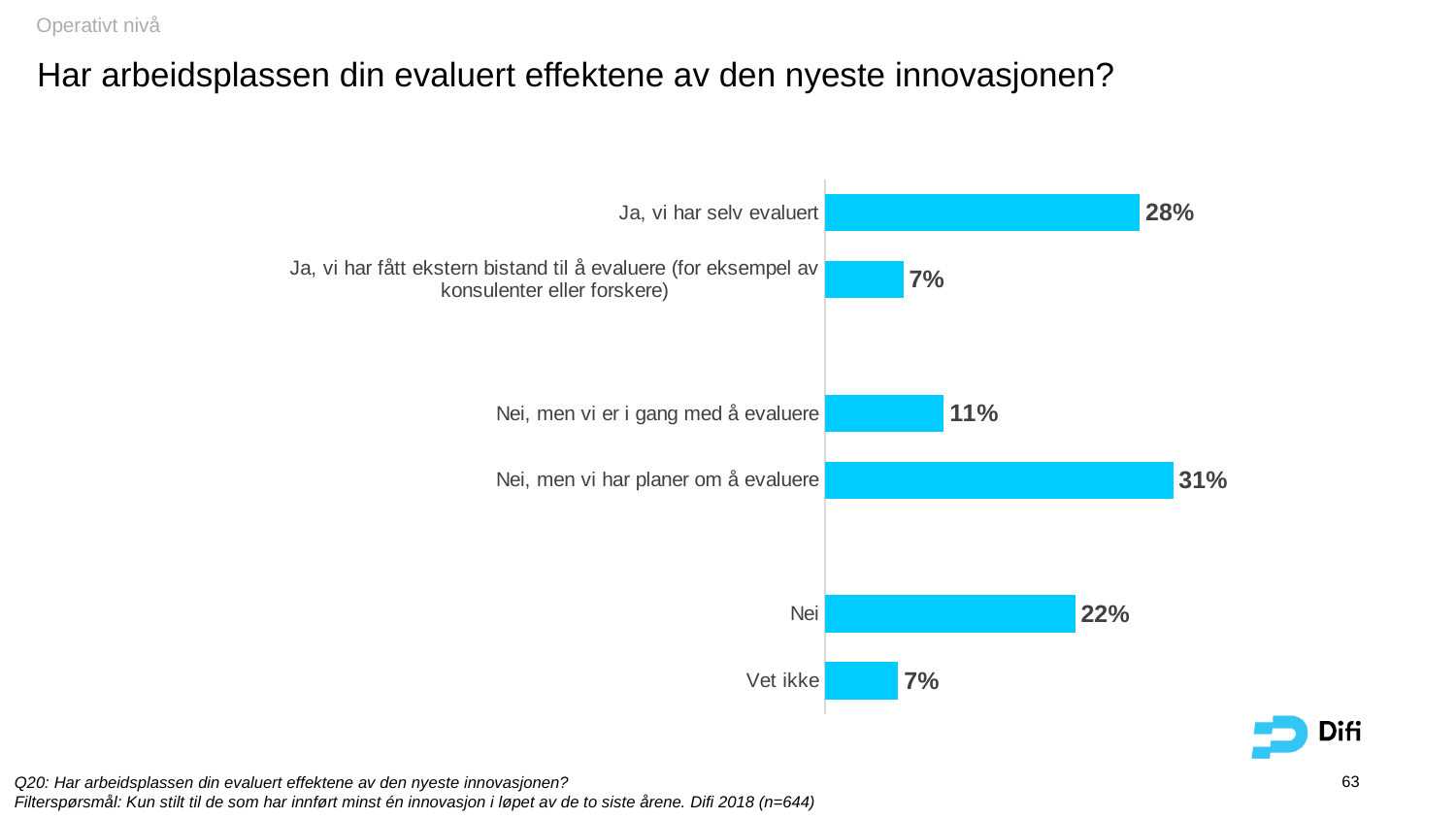
What percentage is shown for "Nei, men vi har planer om å evaluere"? 31% What is the difference between "Nei" and "Nei, men vi er i gang med å evaluere"? 11% What is the title of the slide? Har arbeidsplassen din evaluert effektene av den nyeste innovasjonen? What is the difference between "Nei, men vi har planer om å evaluere" and "Ja, vi har selv evaluert"? 3% What percentage is shown for "Nei, men vi er i gang med å evaluere"? 11% What is the value for "Vet ikke"? 7% What kind of chart is shown on the slide? Bar chart How many categories are shown in the chart? 6 What percentage is shown for "Ja, vi har selv evaluert"? 28% What percentage is shown for "Nei"? 22% Which is larger: "Ja, vi har selv evaluert" or "Nei"? Ja, vi har selv evaluert Which category has the highest value? Nei, men vi har planer om å evaluere